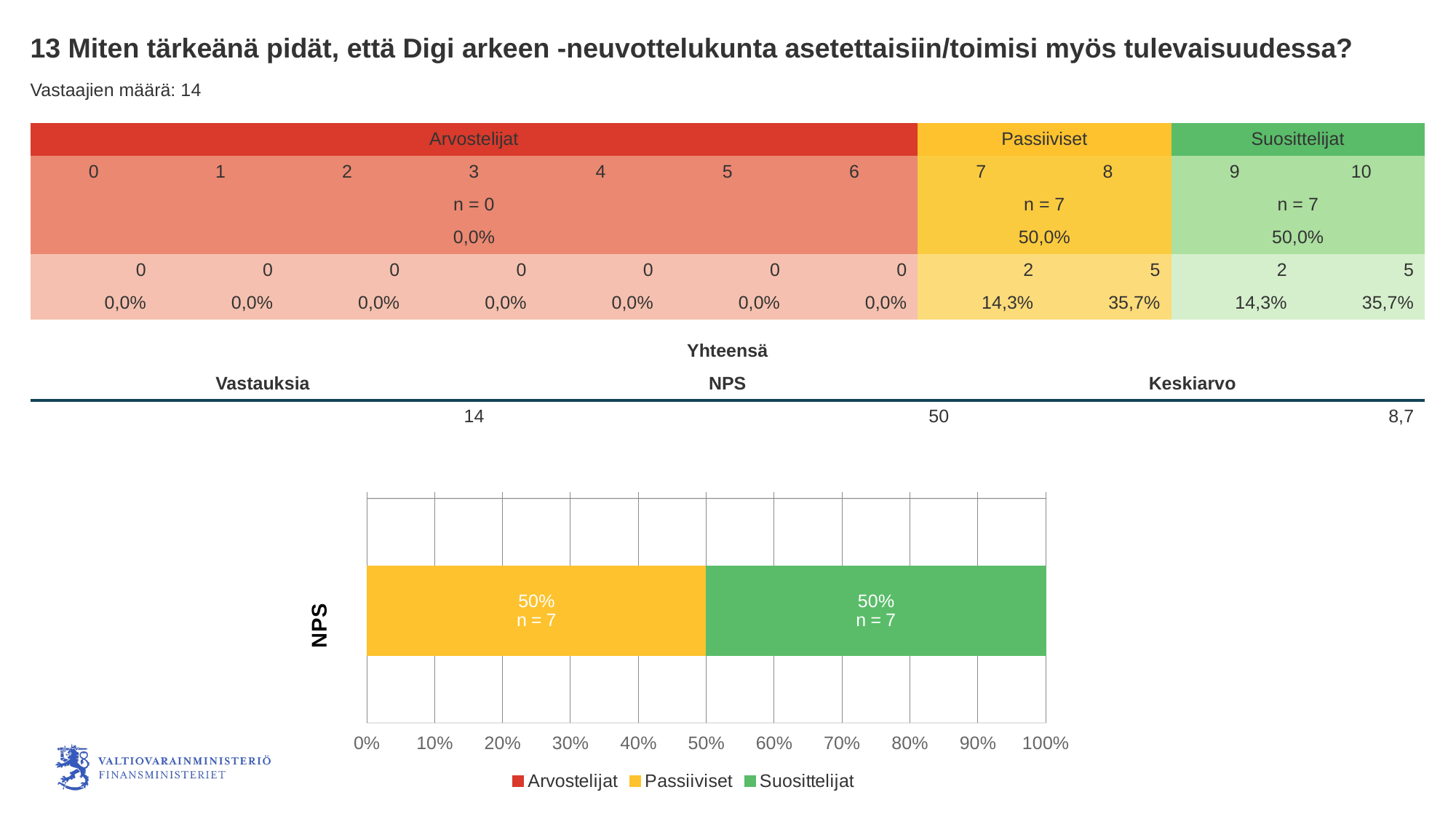
What is the difference between the Passiiviset and Suosittelijat percentages in the bar chart? 0% What is the label of the category on the vertical axis of the bar chart? NPS How many series does the legend of the bar chart list? 3 Is the value for Passiiviset in the bar chart greater or less than 40%? greater What is the percentage shown for Passiiviset in the bar chart? 50% What is the n value shown for Suosittelijat in the bar chart? n = 7 What is the total of the Passiiviset and Suosittelijat segments in the stacked bar? 100% What is the percentage shown for Suosittelijat in the bar chart? 50% What is the n value shown for Passiiviset in the bar chart? n = 7 Which legend entry is shown in green in the bar chart? Suosittelijat What kind of chart is shown at the bottom of the slide? bar chart How many categories are plotted on the vertical axis of the bar chart? 1